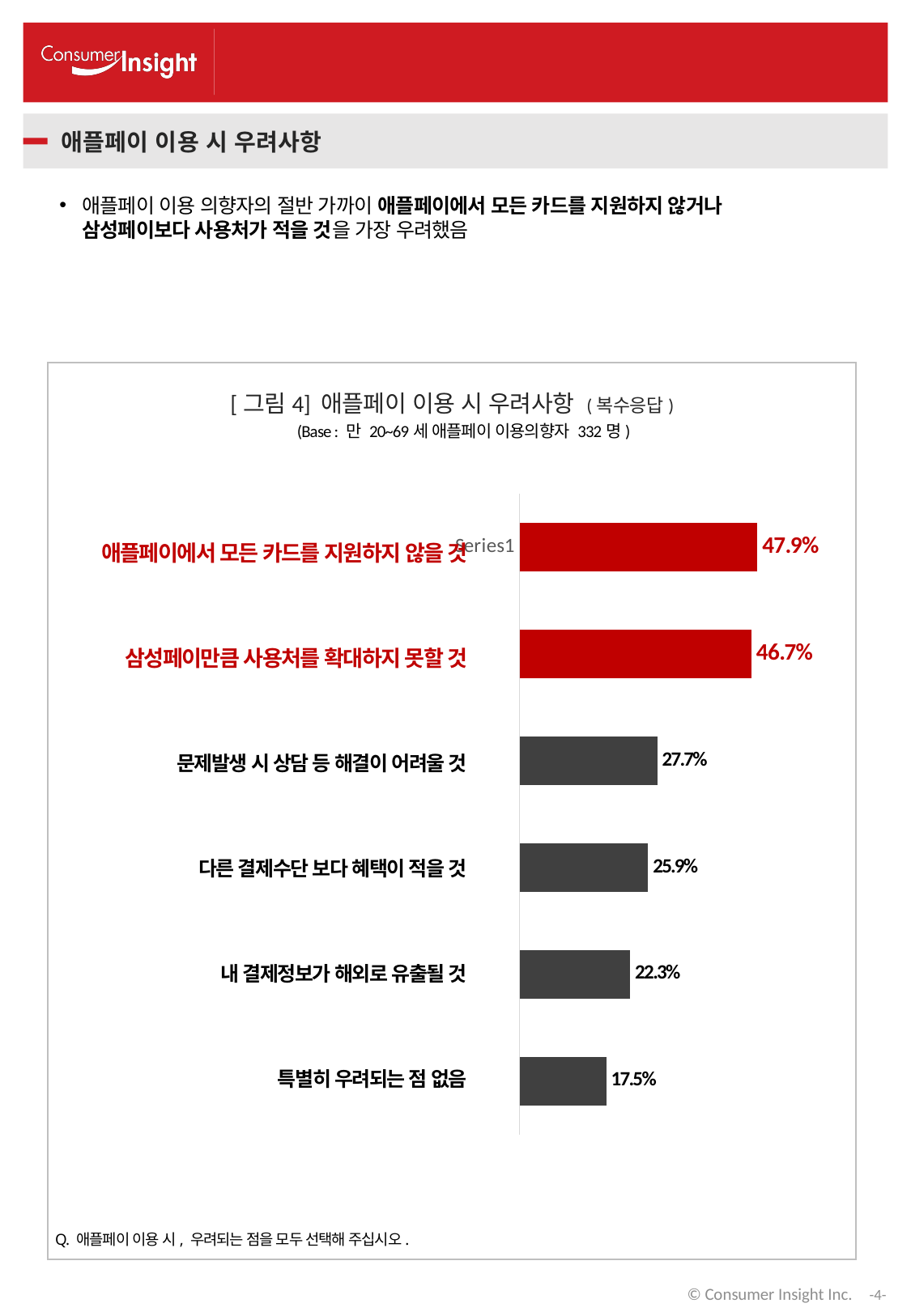
What is the difference between the values for '문제발생 시 상담 등 해결이 어려울 것' and '다른 결제수단 보다 혜택이 적을 것'? 1.8% How many categories are shown in the chart? 6 What is the difference between the values for '애플페이에서 모든 카드를 지원하지 않을 것' and '특별히 우려되는 점 없음'? 30.4% What is the value for '내 결제정보가 해외로 유출될 것'? 22.3% Which is larger: the value for '다른 결제수단 보다 혜택이 적을 것' or the value for '내 결제정보가 해외로 유출될 것'? 다른 결제수단 보다 혜택이 적을 것 What is the value for '삼성페이만큼 사용처를 확대하지 못할 것'? 46.7% What is the value for '문제발생 시 상담 등 해결이 어려울 것'? 27.7% How many bars are coloured red in the chart? 2 Which category has the highest value? 애플페이에서 모든 카드를 지원하지 않을 것 What is the value for '애플페이에서 모든 카드를 지원하지 않을 것'? 47.9% What kind of chart is shown on the slide? Bar chart Which category has the lowest value? 특별히 우려되는 점 없음